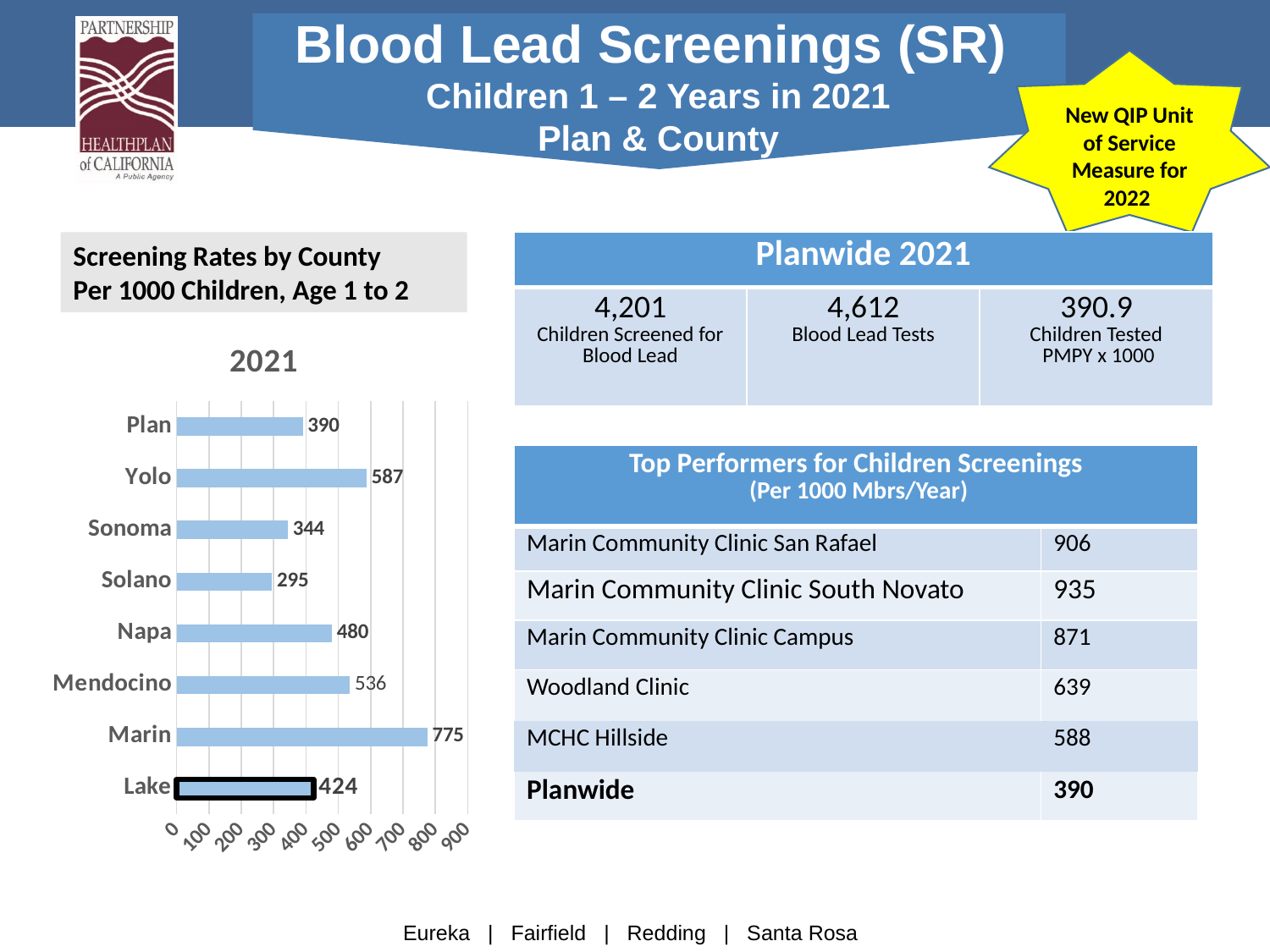
Is the value for Mendocino in the 2021 bar chart greater or less than 500? greater What is the value for Lake in the 2021 bar chart? 424 What is the title shown above the bar chart? 2021 What kind of chart is used to show screening rates by county? Bar chart Which category has the lowest value in the 2021 bar chart? Solano What is the screening rate for Marin in the 2021 bar chart? 775 What is the difference between the Marin and Lake values in the 2021 bar chart? 351 Which county has the highest screening rate in the 2021 bar chart? Marin What is the screening rate for Solano in the 2021 bar chart? 295 What is the difference between the Yolo and Plan values in the 2021 bar chart? 197 How many categories are shown in the 2021 bar chart? 8 In the 2021 bar chart, which is larger, Napa or Sonoma? Napa